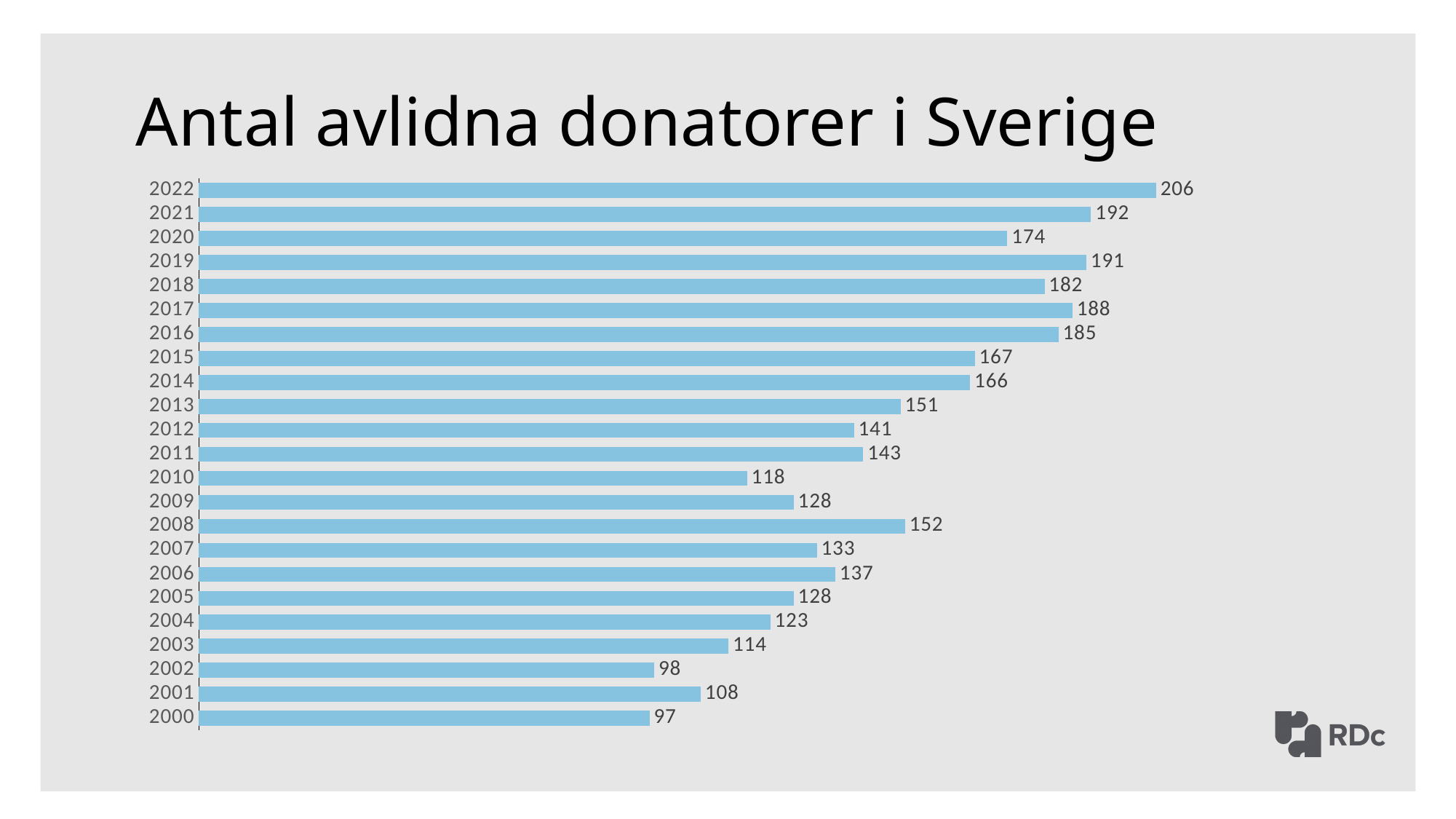
What is the title of the chart? Antal avlidna donatorer i Sverige What is the value for 2010? 118 How many years are shown in the chart? 23 What is the difference between the values for 2022 and 2021? 14 What is the value for 2022? 206 What kind of chart is shown on the slide? Bar chart What is the difference between the values for 2008 and 2007? 19 Which year has the highest value? 2022 Which is larger, the value for 2019 or the value for 2020? 2019 Which year has the lowest value? 2000 What is the value for 2000? 97 Which is larger, the value for 2002 or the value for 2001? 2001